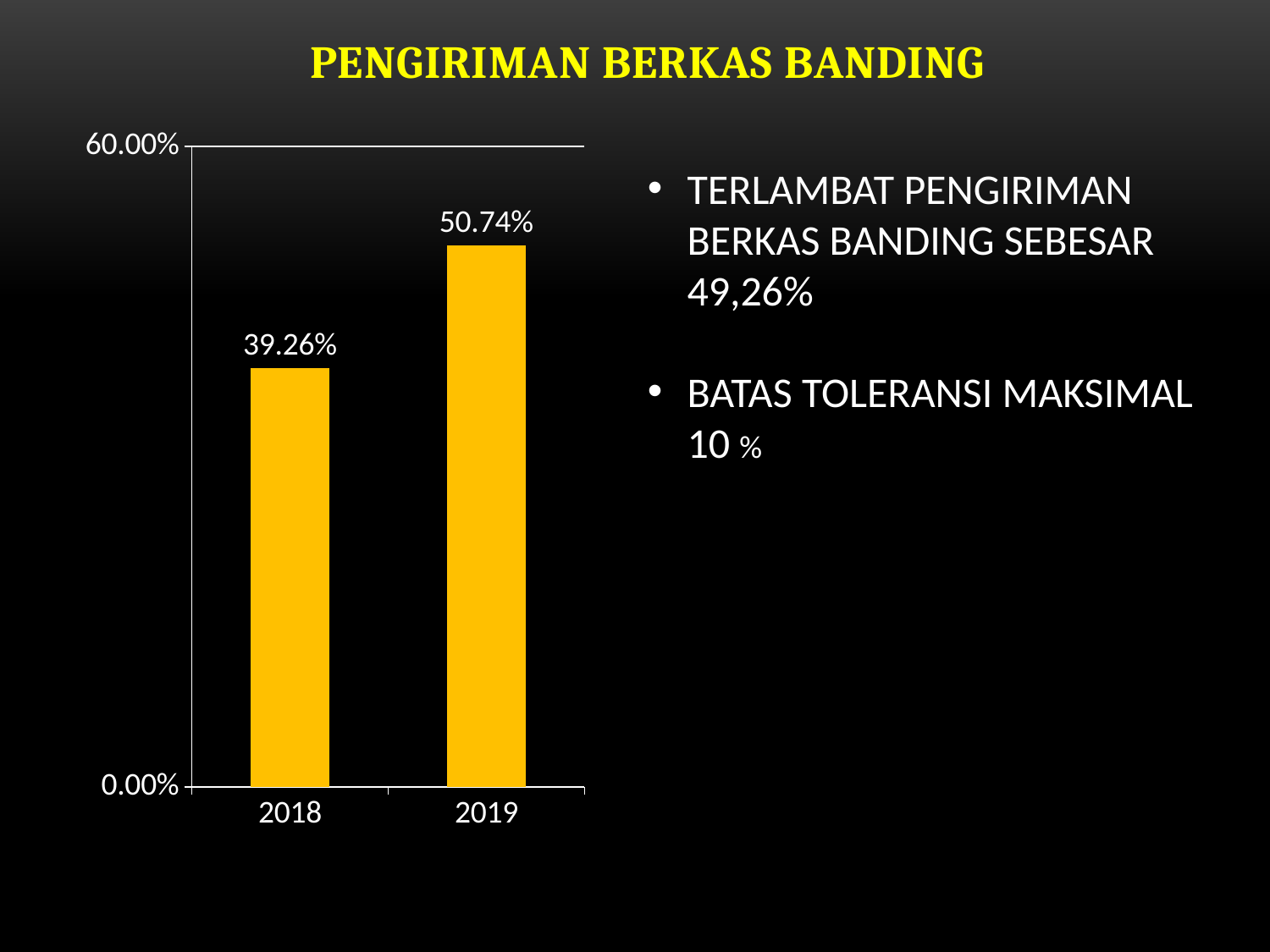
Which is larger, the value for 2018 or the value for 2019? 2019 Which year has the highest value? 2019 What is the value for 2019? 50.74% What is the title of the slide containing the chart? PENGIRIMAN BERKAS BANDING Which year has the lowest value? 2018 What kind of chart is shown on the slide? bar chart What is the difference between the values for 2019 and 2018? 11.48% What is the value for 2018? 39.26% Do the values rise or fall from 2018 to 2019? rise What colour are the bars in the chart? yellow How many categories are shown on the x axis? 2 What is the maximum value shown on the y axis? 60.00%